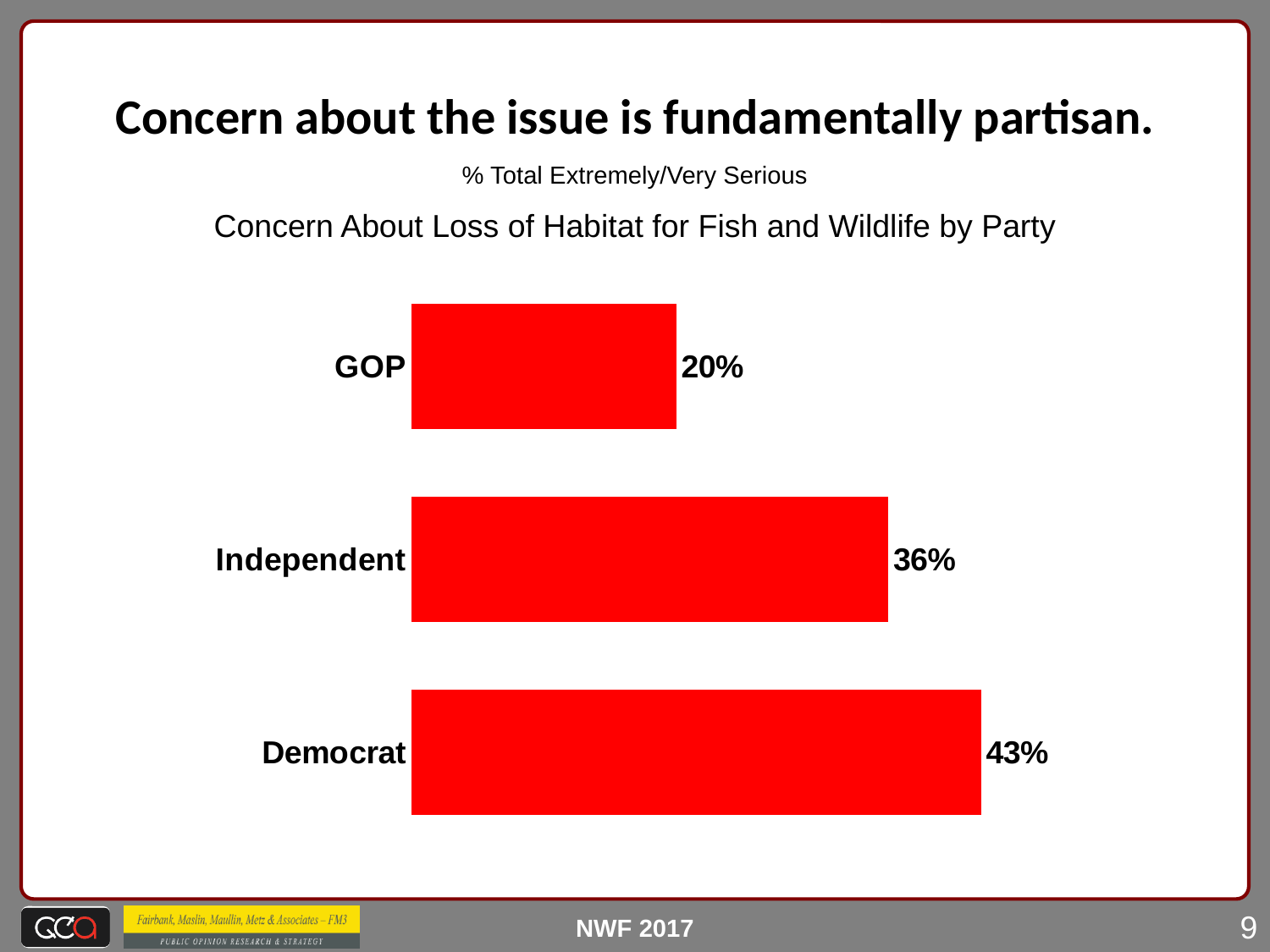
What is the value shown for Democrat? 43% What colour are the bars in the chart? Red Which is larger, the value for Independent or the value for GOP? Independent What type of chart is shown on the slide? Bar chart Which party has the lowest share rating the issue extremely/very serious? GOP Which party has the highest share rating the issue extremely/very serious? Democrat What is the title of the chart? Concern About Loss of Habitat for Fish and Wildlife by Party How many party categories are shown in the chart? 3 What is the difference in percentage points between Democrat and GOP? 23 What is the difference in percentage points between Independent and GOP? 16 What is the value shown for Independent? 36% What percentage of GOP respondents rate loss of habitat for fish and wildlife as extremely/very serious? 20%